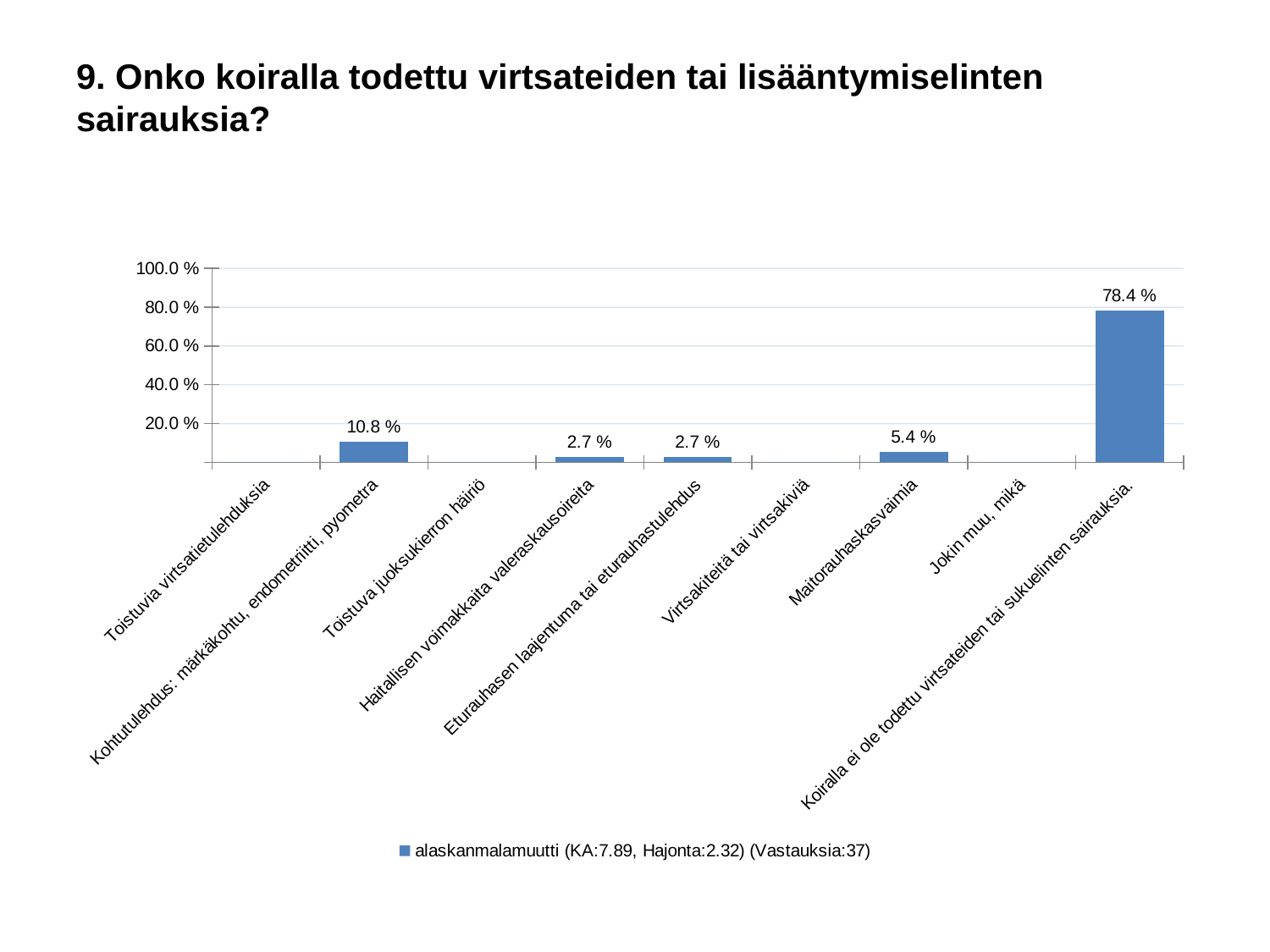
What is the difference between the values for "Koiralla ei ole todettu virtsateiden tai sukuelinten sairauksia." and "Kohtutulehdus: märkäkohtu, endometriitti, pyometra"? 67.6 % Which category has the highest value? Koiralla ei ole todettu virtsateiden tai sukuelinten sairauksia. Which is larger, the value for "Maitorauhaskasvaimia" or the value for "Eturauhasen laajentuma tai eturauhastulehdus"? Maitorauhaskasvaimia How many categories are shown on the x axis? 9 What is the value for "Koiralla ei ole todettu virtsateiden tai sukuelinten sairauksia."? 78.4 % Is the value for "Koiralla ei ole todettu virtsateiden tai sukuelinten sairauksia." greater or less than 60.0 %? greater How many series does the legend list? 1 What is the difference between the values for "Kohtutulehdus: märkäkohtu, endometriitti, pyometra" and "Maitorauhaskasvaimia"? 5.4 % What is the value for "Kohtutulehdus: märkäkohtu, endometriitti, pyometra"? 10.8 % What is the value for "Haitallisen voimakkaita valeraskausoireita"? 2.7 % What is the value for "Maitorauhaskasvaimia"? 5.4 % What kind of chart is shown on the slide? bar chart